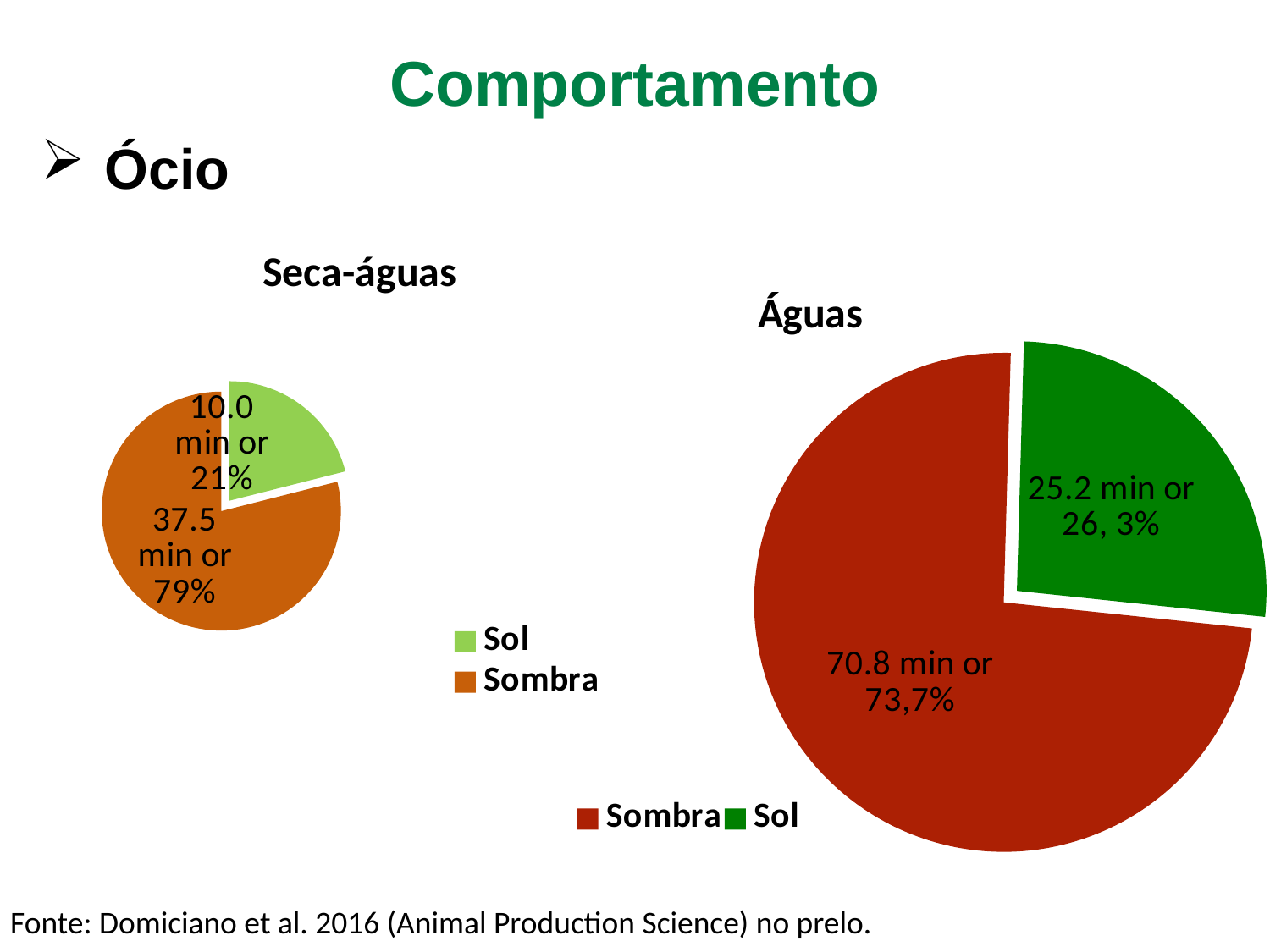
In the Seca-águas chart, what share of the pie does Sombra take? 79% In the Águas chart, what share of the pie does Sol take? 26, 3% In the Águas chart, what is the value shown for Sombra? 70.8 min or 73,7% In the Seca-águas chart, how many minutes more is Sombra than Sol? 27.5 min In the Águas chart, how many minutes more is Sombra than Sol? 45.6 min In the Seca-águas chart, what is the value shown for Sombra? 37.5 min or 79% In the Seca-águas chart, what is the value shown for Sol? 10.0 min or 21% In the Águas chart, which category is the smallest? Sol How many slices does the Seca-águas chart have? 2 In the Águas chart, what is the value shown for Sol? 25.2 min or 26, 3% In the Seca-águas chart, which category is the largest? Sombra What kind of chart is the Águas chart? Pie chart